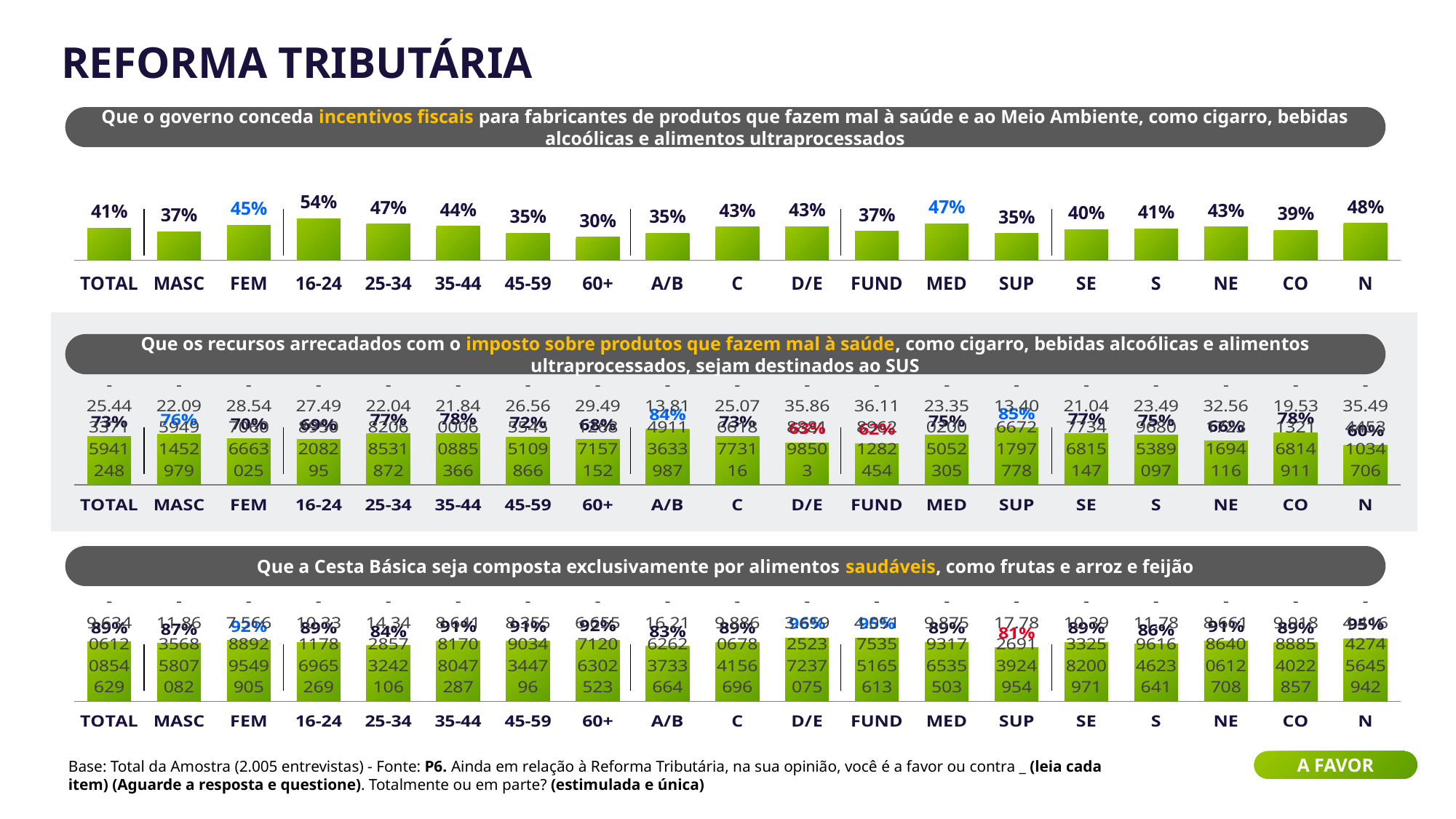
In the top chart about tax incentives (incentivos fiscais), what is the value for 60+? 30% In the top chart about tax incentives (incentivos fiscais), what is the difference between FEM and MASC? 8% In the top chart about tax incentives (incentivos fiscais), which category has the lowest value? 60+ In the top chart about tax incentives (incentivos fiscais), do the values rise or fall across the age groups from 16-24 to 60+? fall In the top chart about tax incentives (incentivos fiscais), what is the value for TOTAL? 41% In the middle chart about tax revenue going to SUS, what is the value for A/B? 84% What type of chart is the top chart about tax incentives (incentivos fiscais)? bar chart In the top chart about tax incentives (incentivos fiscais), how many categories are shown? 19 In the top chart about tax incentives (incentivos fiscais), which category has the highest value? 16-24 In the top chart about tax incentives (incentivos fiscais), what is the value for N? 48% In the bottom chart about the Cesta Básica, what is the value for SUP? 81% In the top chart about tax incentives (incentivos fiscais), which is larger, MED or FUND? MED